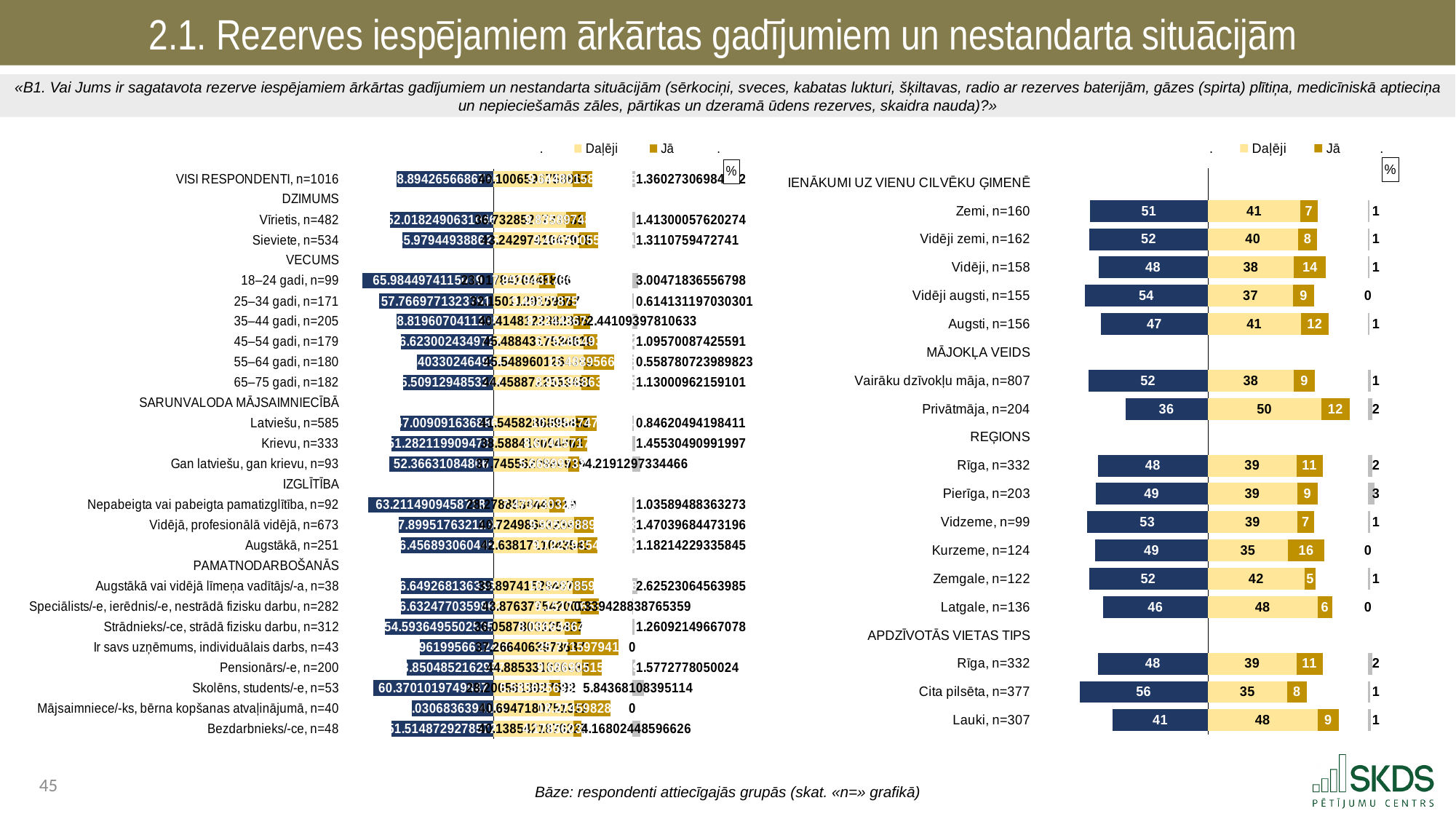
In the right chart, what is the "Jā" value for Kurzeme, n=124? 16 In the right chart, which has the larger "Jā" value: Vidēji, n=158 or Augsti, n=156? Vidēji, n=158 In the right chart, what is the value of the dark blue bar for Cita pilsēta, n=377? 56 In the right chart, what is the difference between the "Daļēji" values for Privātmāja, n=204 and Vairāku dzīvokļu māja, n=807? 12 In the right chart, how many income categories are listed under IENĀKUMI UZ VIENU CILVĒKU ĢIMENĒ? 5 In the right chart, what is the "Jā" value for Cita pilsēta, n=377? 8 In the right chart, which region under REĢIONS has the highest "Jā" value? Kurzeme, n=124 Which two series names are readable in the legend of the right chart? Daļēji and Jā In the right chart, which region under REĢIONS has the lowest "Jā" value? Zemgale, n=122 What kind of chart is the right chart? bar chart In the right chart, what is the "Daļēji" value for Privātmāja, n=204? 50 In the right chart, what is the "Daļēji" value for Latgale, n=136? 48